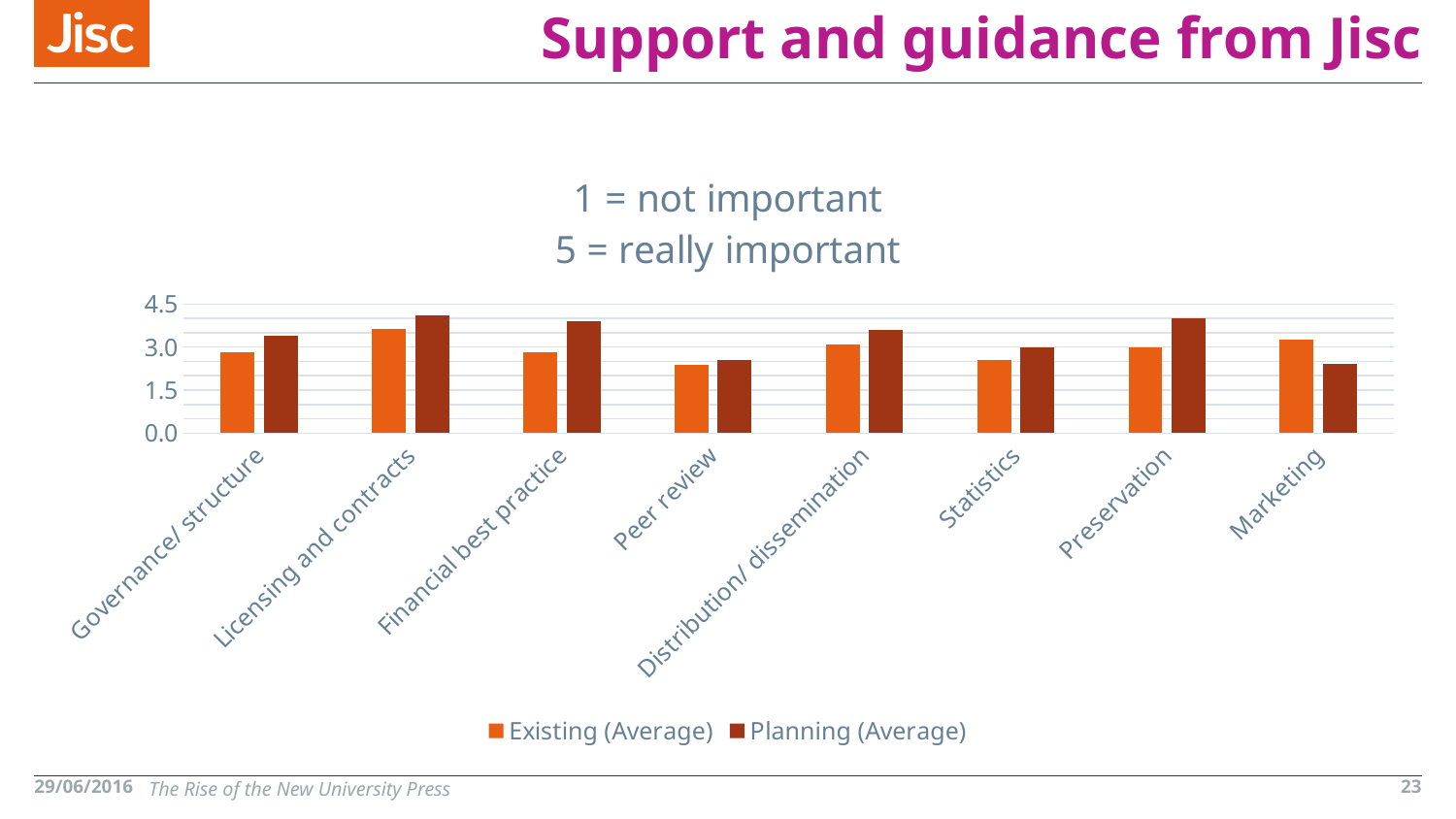
Is the Planning (Average) value for Licensing and contracts greater or less than 3.0? greater Is the Planning (Average) value for Marketing greater or less than 3.0? less What kind of chart is shown on the slide? bar chart How many categories are shown on the x axis of the chart? 8 For Marketing, which series has the larger value, Existing (Average) or Planning (Average)? Existing (Average) Is the Planning (Average) value for Financial best practice greater or less than 3.0? greater For Preservation, which series has the larger value, Existing (Average) or Planning (Average)? Planning (Average) What is the title of the slide containing the chart? Support and guidance from Jisc Which category has the highest Existing (Average) value? Licensing and contracts What are the two series named in the chart's legend? Existing (Average) and Planning (Average) How many series does the chart's legend list? 2